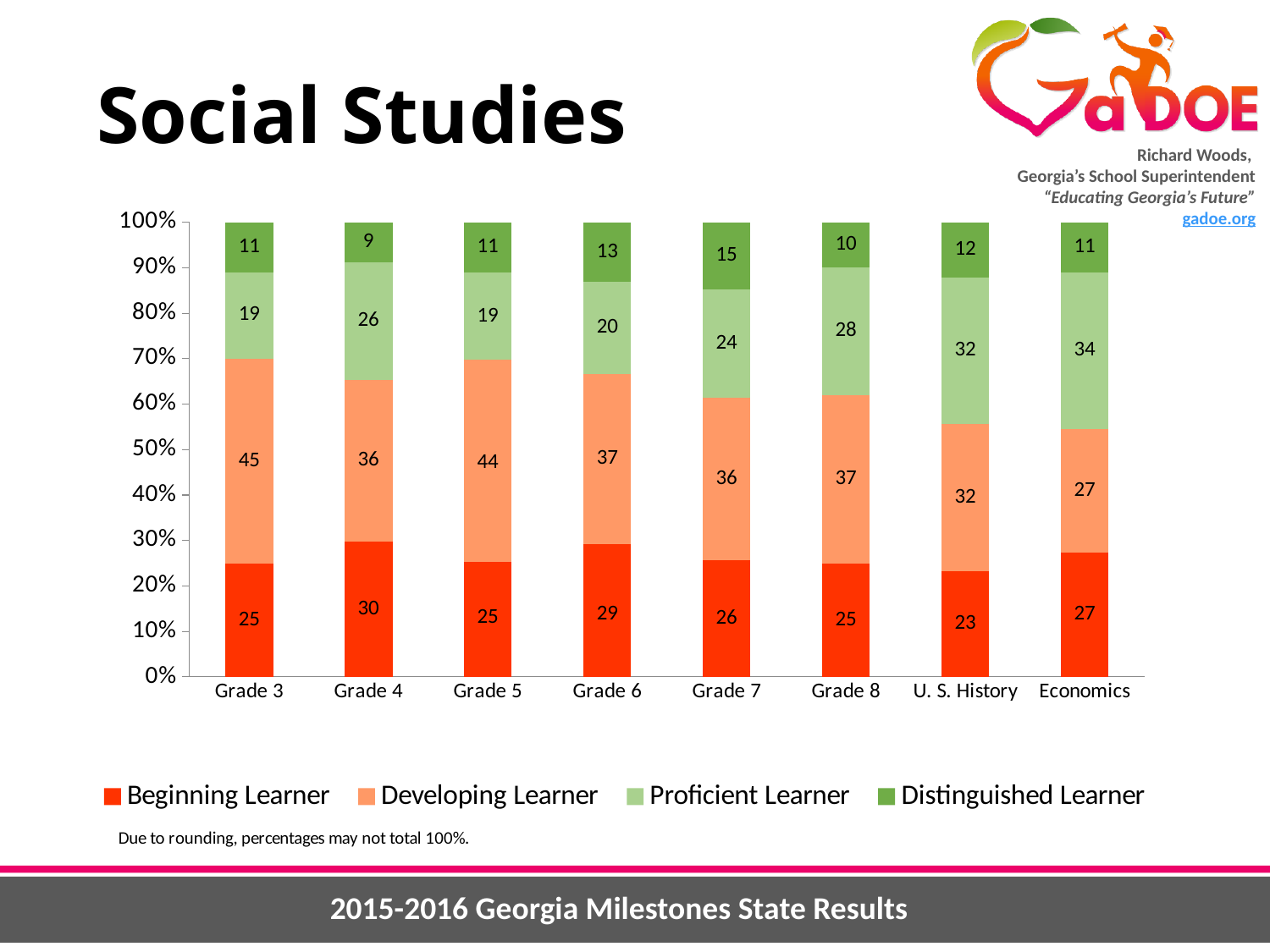
What is the Proficient Learner value for Economics? 34 Which category has the lowest Beginning Learner value? U. S. History What is the total of the stacked bar for U. S. History? 99 What is the difference between the Developing Learner values for Grade 3 and Economics? 18 How many categories are shown on the x axis? 8 How many series does the legend list? 4 What is the Distinguished Learner value for Grade 7? 15 What is the Beginning Learner value for Grade 4? 30 Which category has the highest Distinguished Learner value? Grade 7 Which is larger, the Proficient Learner value for Grade 4 or for Grade 5? Grade 4 What kind of chart is shown on the slide? Stacked bar chart What is the Developing Learner value for Grade 3? 45